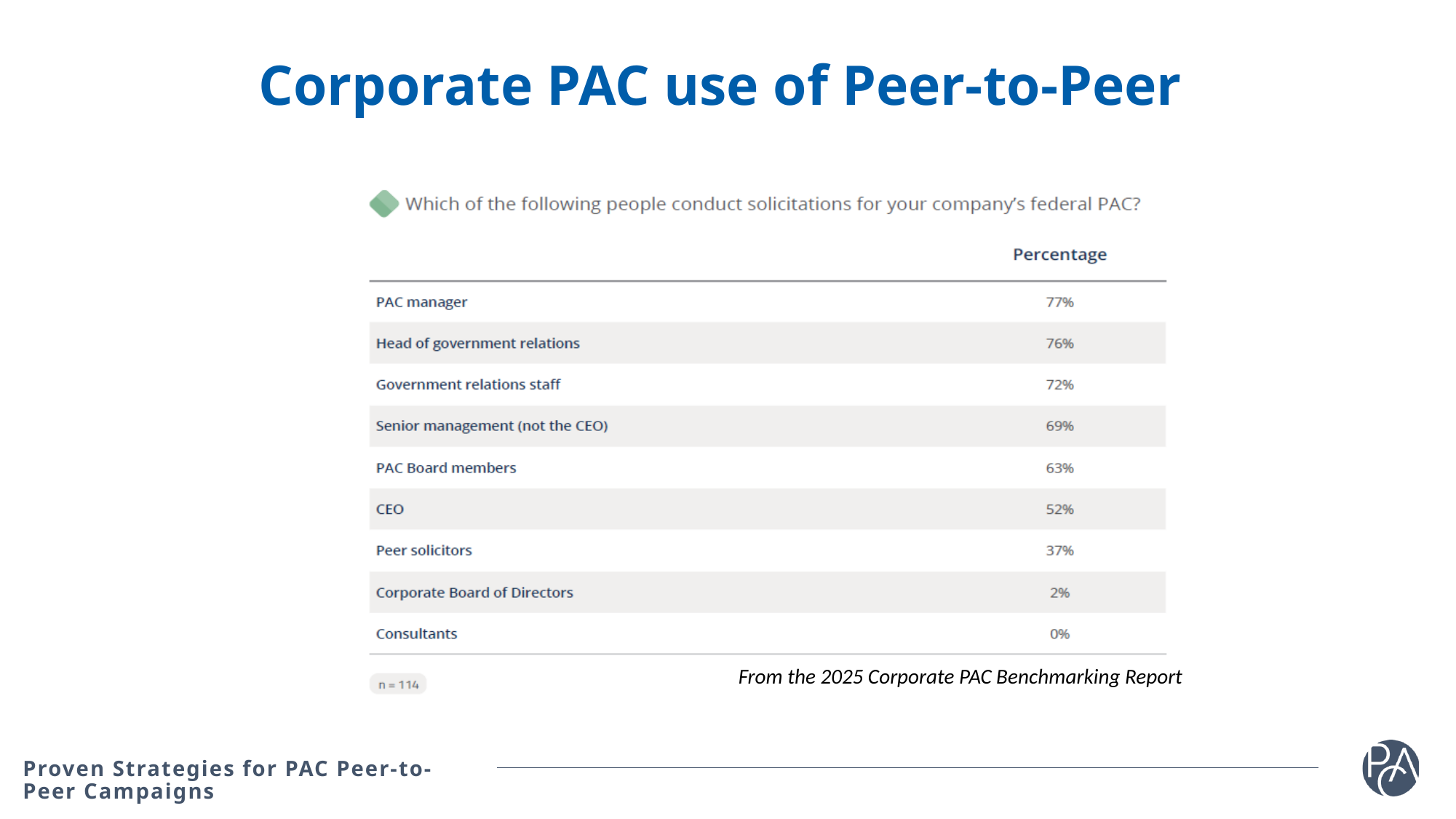
In the table, what percentage is shown for Corporate Board of Directors? 2% Which has a higher percentage, Senior management (not the CEO) or CEO? Senior management (not the CEO) Which category in the table has the lowest percentage? Consultants In the table, what percentage is shown for PAC manager? 77% What is the sample size (n) shown below the table? 114 In the table, what percentage is shown for CEO? 52% What is the difference in percentage between Head of government relations and Government relations staff? 4% What is the difference in percentage between PAC Board members and Peer solicitors? 26% How many categories are listed in the table? 9 In the table, what percentage is shown for Peer solicitors? 37% Which category in the table has the highest percentage? PAC manager What question does the table answer, as printed above it? Which of the following people conduct solicitations for your company's federal PAC?